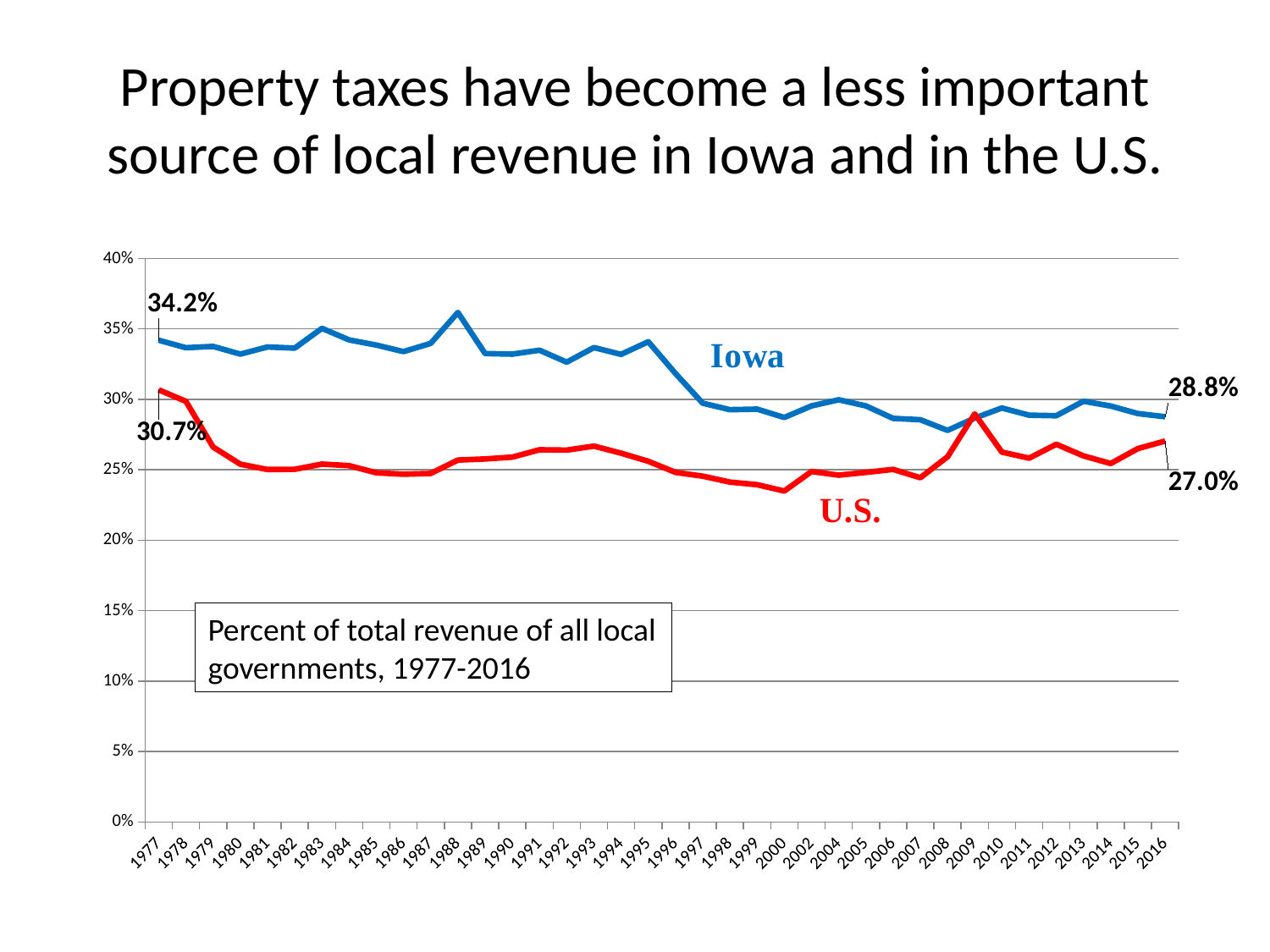
What kind of chart is shown on the slide? line chart In 2016, which was higher, Iowa or the U.S.? Iowa In which year did Iowa reach its highest value? 1988 By how many percentage points did the U.S. value fall from 1977 to 2016? 3.7 percentage points What was Iowa's value in 1977? 34.2% What was the U.S. value in 1977? 30.7% What was the U.S. value in 2016? 27.0% What was Iowa's value in 2016? 28.8% By how many percentage points did Iowa's value fall from 1977 to 2016? 5.4 percentage points Which colour is used for the Iowa line? blue Is Iowa's value in 1988 greater or less than 35%? greater Is the U.S. value in 2000 greater or less than 25%? less